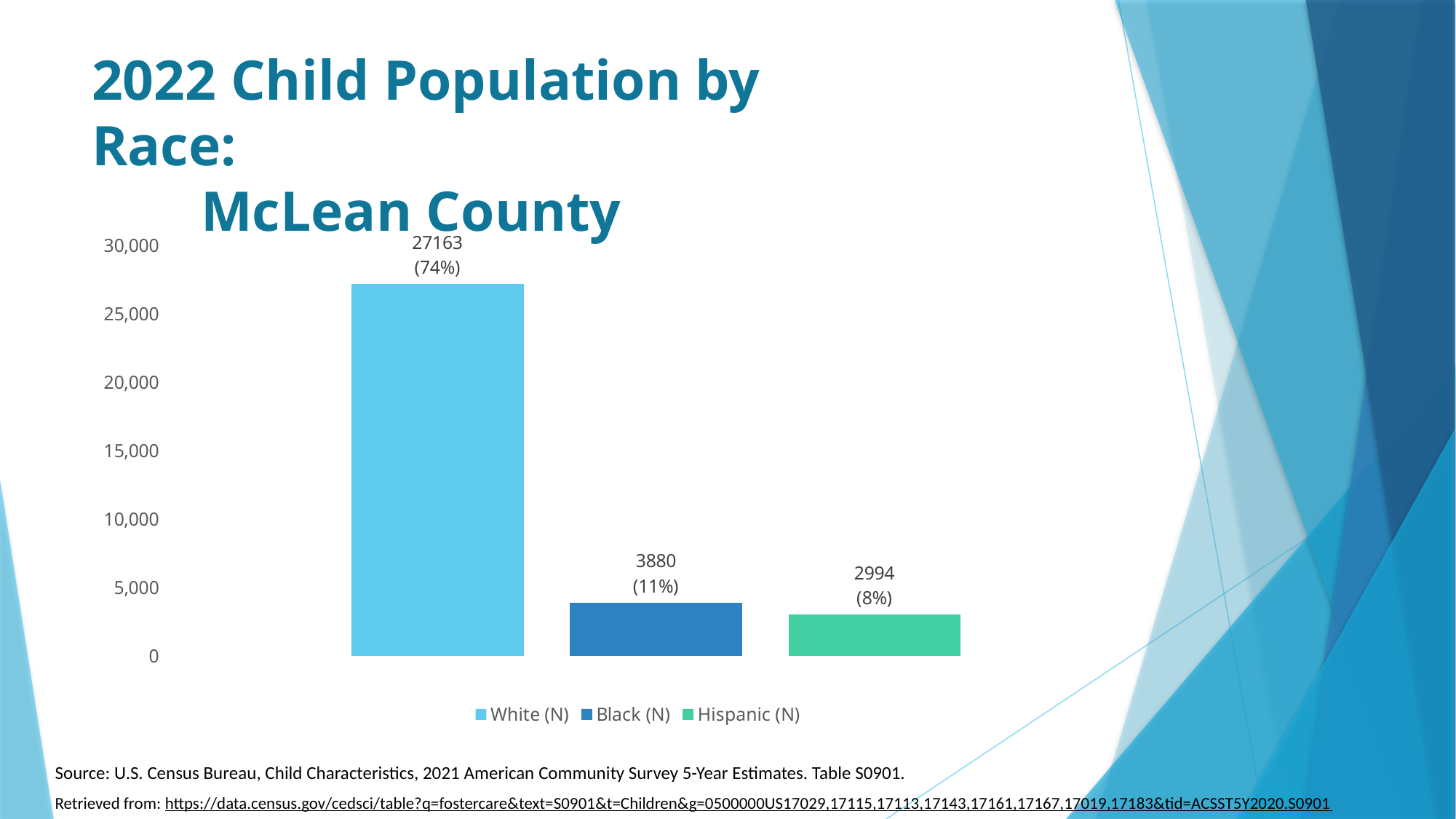
Which category has the highest value? White (N) What is the difference between the White (N) and Black (N) values? 23283 How many series does the legend list? 3 Is the value for White (N) greater or less than 25,000? greater What percentage is shown for the Black (N) bar? 11% Which category has the lowest value? Hispanic (N) What kind of chart is shown on the slide? bar chart What is the value for Hispanic (N)? 2994 What is the difference between the Black (N) and Hispanic (N) values? 886 Which is larger, the value for Black (N) or Hispanic (N)? Black (N) What is the value for White (N)? 27163 What is the value for Black (N)? 3880